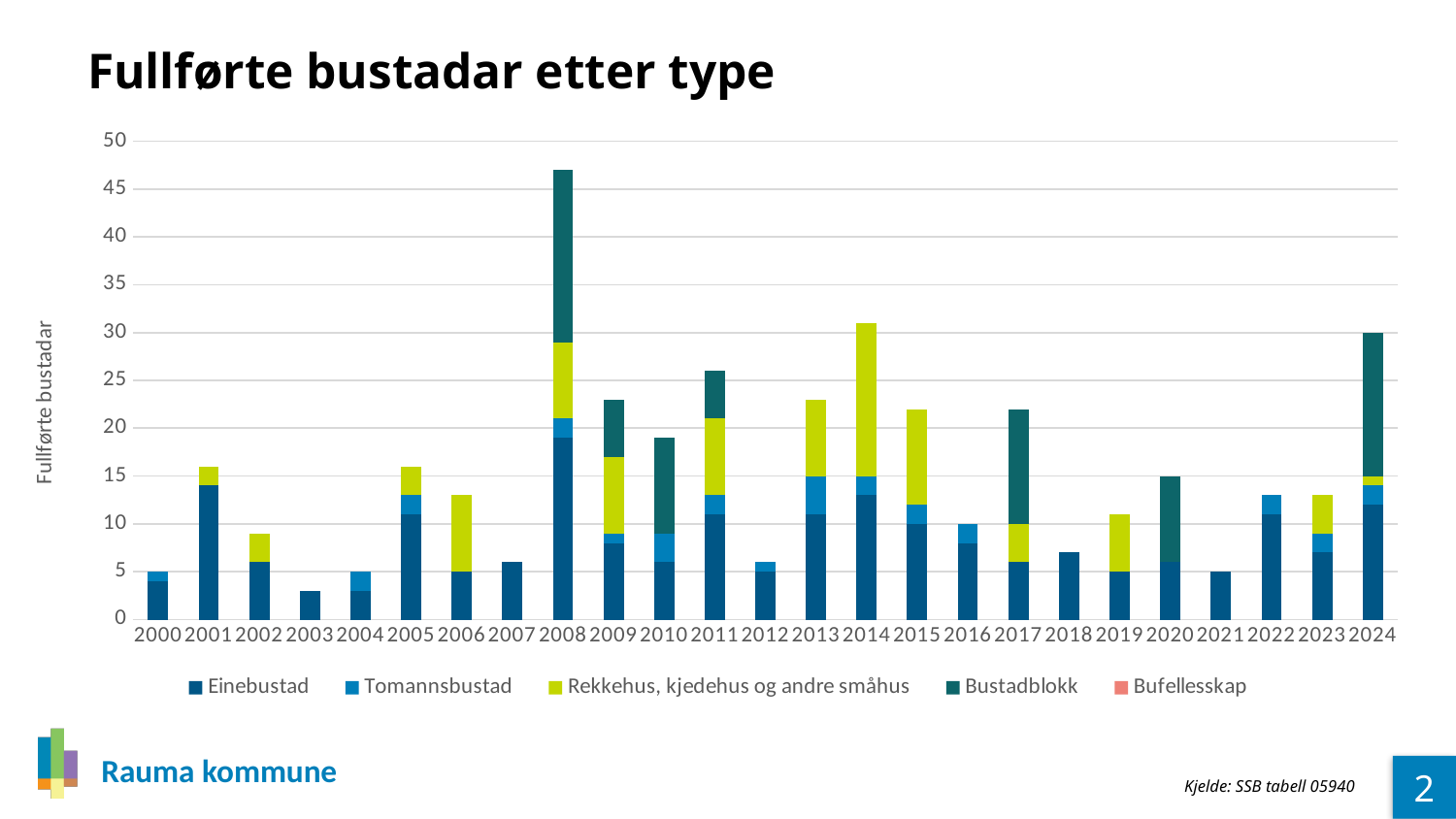
How many series does the legend list? 5 Is the total value for 2014 greater or less than 25? greater Which year has the lowest total of completed dwellings? 2003 How many years are shown along the x axis? 25 What kind of chart is shown on the slide? Stacked bar chart Which series is shown in light green in the legend? Rekkehus, kjedehus og andre småhus Is the total value for 2003 greater or less than 5? less What is the title of the chart? Fullførte bustadar etter type Is the total value for 2008 greater or less than 40? greater Which year has a larger total, 2001 or 2002? 2001 Which year has the highest total of completed dwellings? 2008